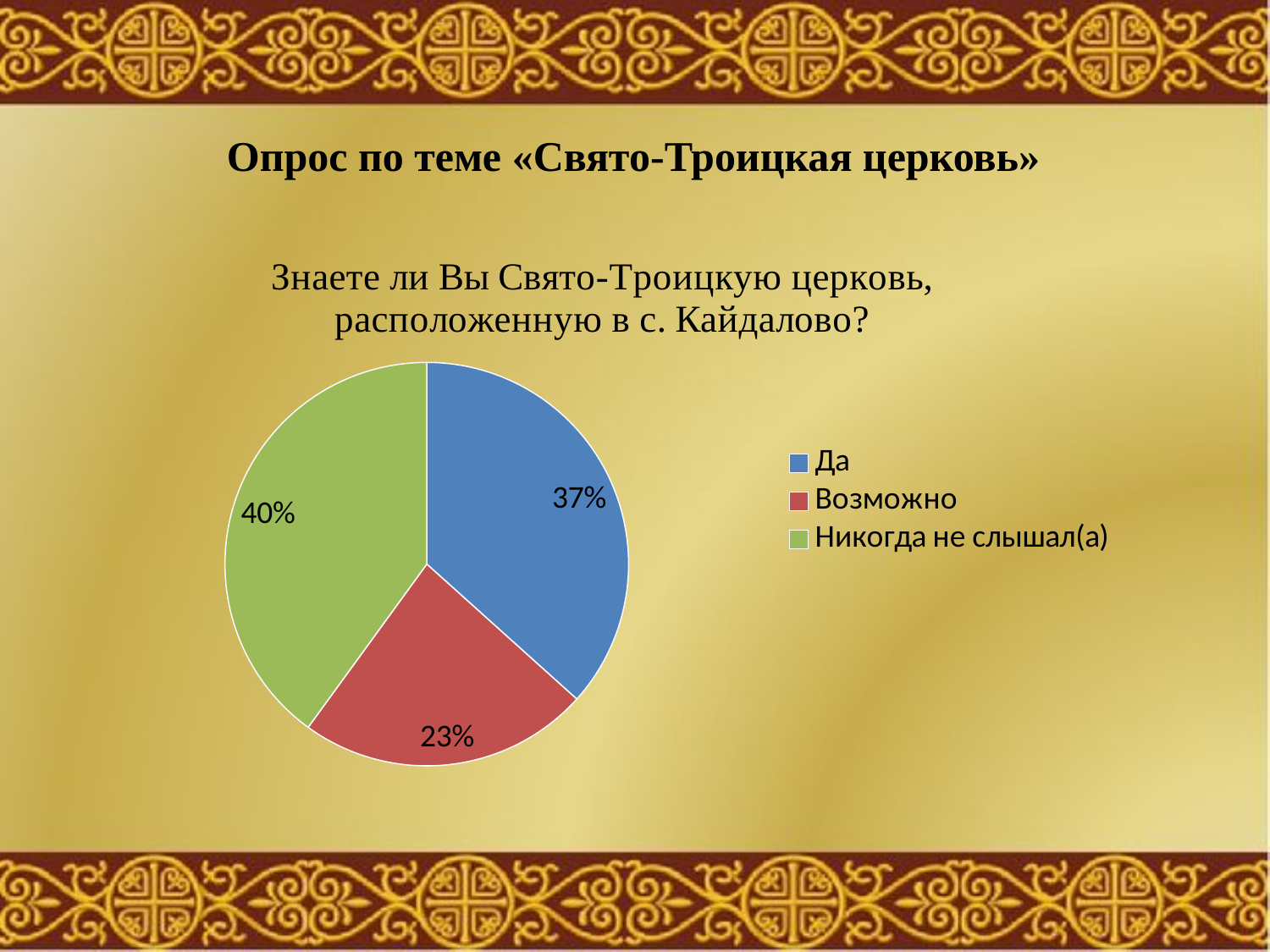
Which answer has the largest share of the pie? Никогда не слышал(а) How many slices does the pie chart have? 3 What share of respondents answered «Да»? 37% Which is larger, the share for «Да» or the share for «Возможно»? Да What share of respondents answered «Возможно»? 23% What kind of chart is shown on the slide? pie chart Which answer has the smallest share of the pie? Возможно What is the difference in percentage points between «Да» and «Возможно»? 14 What colour is the slice for «Возможно»? red What is the difference in percentage points between «Никогда не слышал(а)» and «Возможно»? 17 What is the title of the chart? Знаете ли Вы Свято-Троицкую церковь, расположенную в с. Кайдалово? What share of respondents answered «Никогда не слышал(а)»? 40%